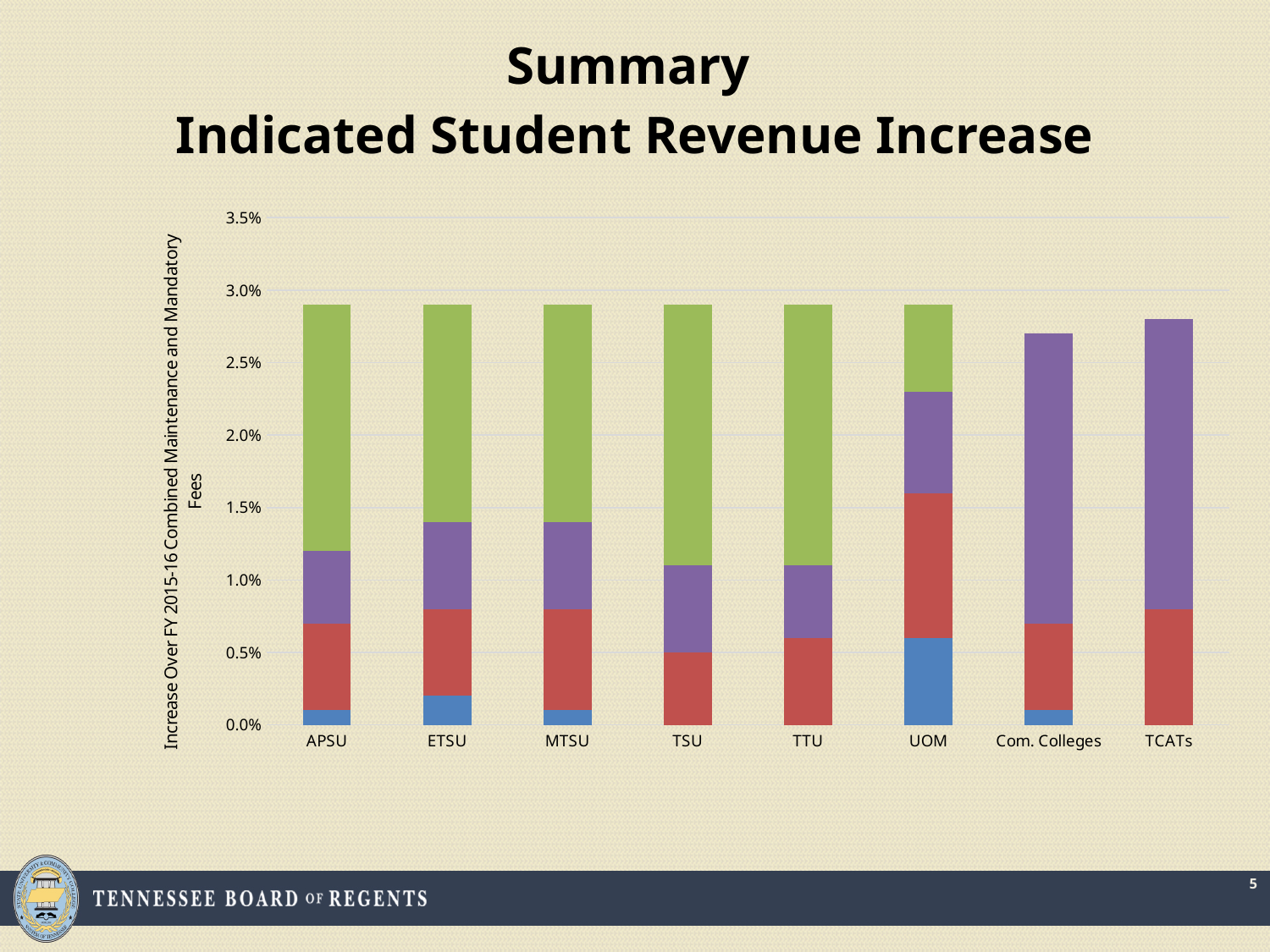
Is the total height of the TCATs bar greater or less than 2.5%? greater What is the label on the vertical axis of the chart? Increase Over FY 2015-16 Combined Maintenance and Mandatory Fees Is the total height of the UOM bar greater or less than 3.0%? less Is the total height of the APSU bar greater or less than 2.5%? greater What kind of chart is shown on the slide? Stacked bar chart How many categories are shown along the x axis of the chart? 8 What is the highest value shown on the vertical axis? 3.5% Which bar has the greater total height, MTSU or Com. Colleges? MTSU Which bar has the greater total height, APSU or Com. Colleges? APSU Which two bars have no green segment? Com. Colleges and TCATs